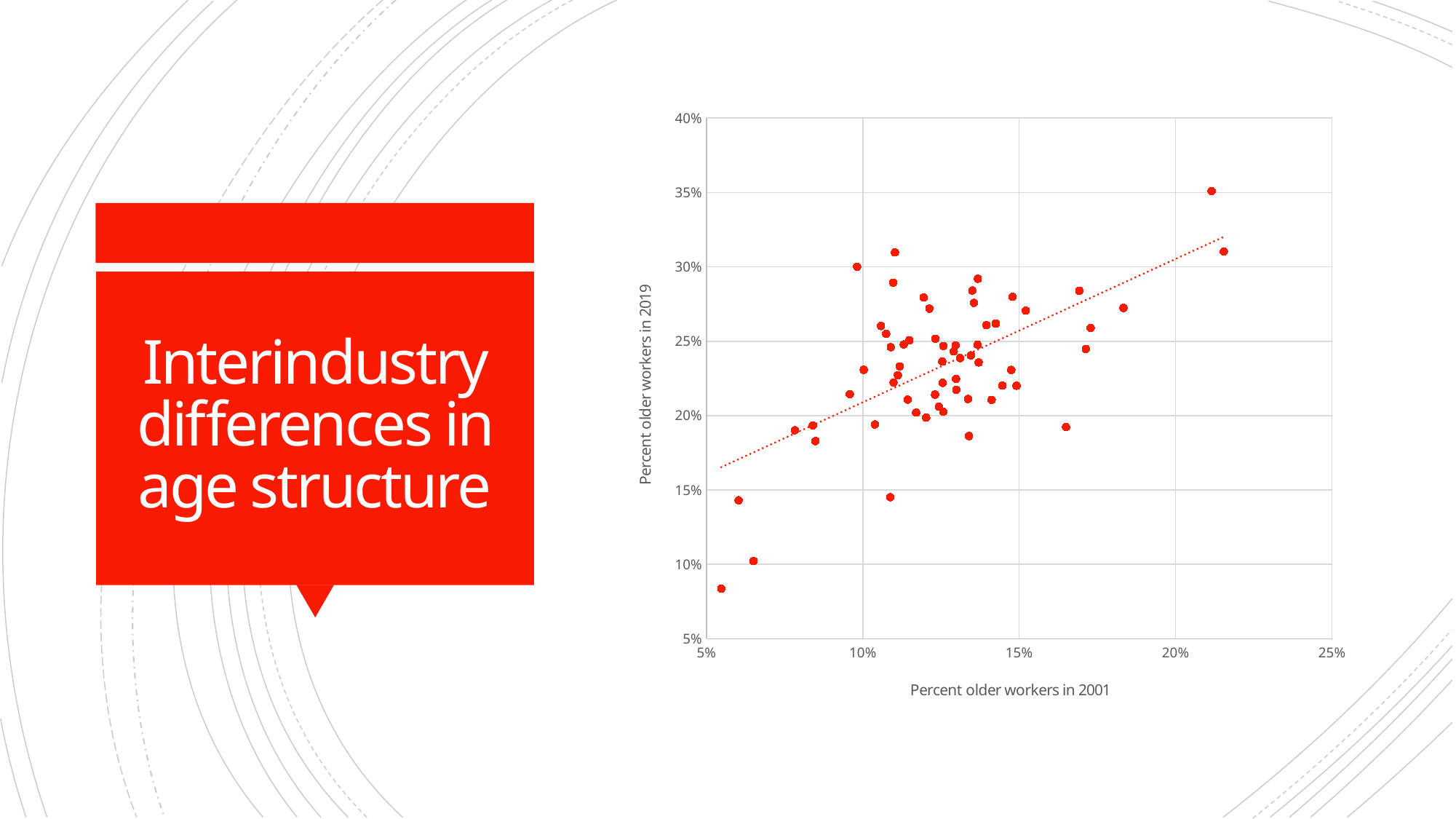
What kind of chart is shown on the slide? Scatter plot What is the maximum value shown on the y axis of the chart? 40% Is the lowest point on the chart above or below 10% on the y axis? Below Is the value on the y axis for the point with the largest x value greater or less than 25%? greater What is the title of the x axis of the chart? Percent older workers in 2001 As the percent of older workers in 2001 increases along the x axis, does the trend line rise or fall? Rise Is the value on the x axis for the rightmost point greater or less than 20%? greater What is the title of the y axis of the chart? Percent older workers in 2019